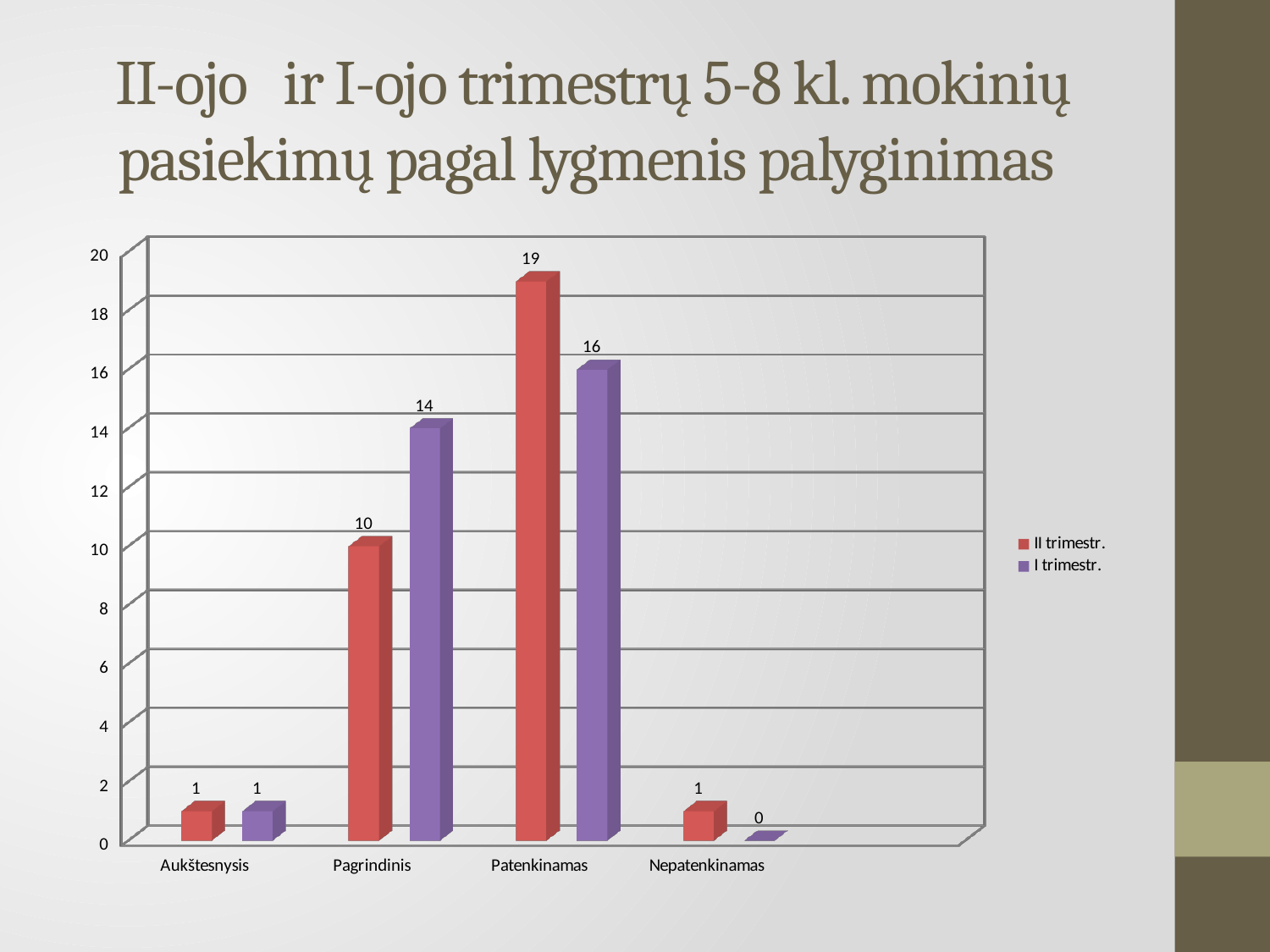
What is the value for Nepatenkinamas in the I trimestr. series? 0 What is the value for Patenkinamas in the II trimestr. series? 19 Which category has the lowest value in the I trimestr. series? Nepatenkinamas What is the difference between the II trimestr. and I trimestr. values for Patenkinamas? 3 Which series is shown in red? II trimestr. What kind of chart is shown on the slide? bar chart Which is larger for Pagrindinis: the II trimestr. value or the I trimestr. value? I trimestr. Which category has the highest value in the II trimestr. series? Patenkinamas How many categories are shown on the x axis? 4 How many series does the legend list? 2 What is the difference between the II trimestr. and I trimestr. values for Pagrindinis? 4 What is the value for Pagrindinis in the I trimestr. series? 14